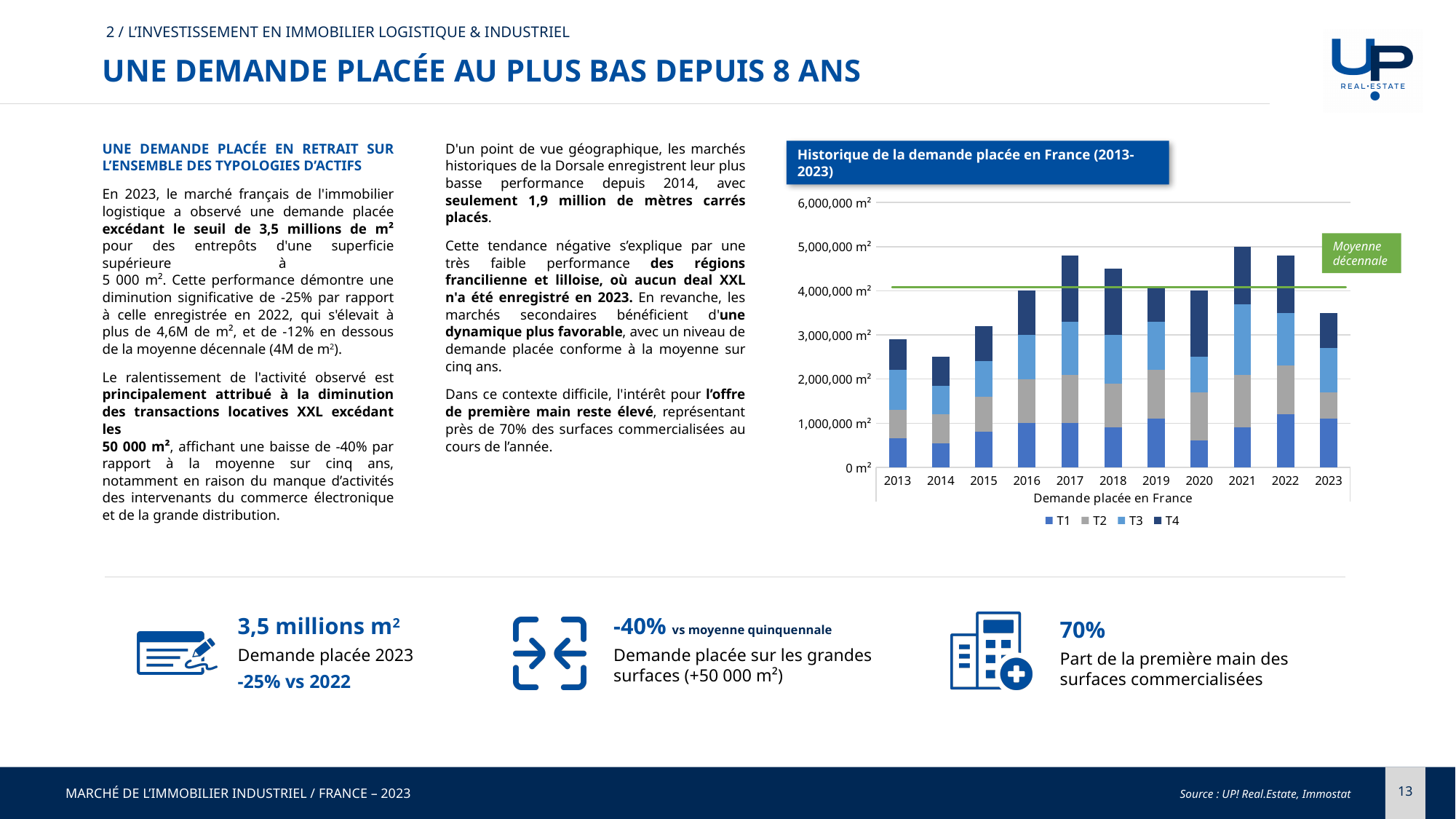
Which year has the highest total demande placée in the chart? 2021 What type of chart is shown on the slide? Stacked bar chart Is the total value for 2014 greater or less than 3,000,000 m²? less Is the total value for 2021 greater or less than 4,000,000 m²? greater How many series does the chart legend list? 4 Which year has a larger total, 2013 or 2015? 2015 Do the total values rise or fall from 2021 to 2023? fall What does the green horizontal line on the chart represent? Moyenne décennale What is the title of the chart? Historique de la demande placée en France (2013-2023) How many years are shown on the x axis of the chart? 11 Is the total value for 2023 greater or less than 4,000,000 m²? less Which year has the lowest total demande placée in the chart? 2014